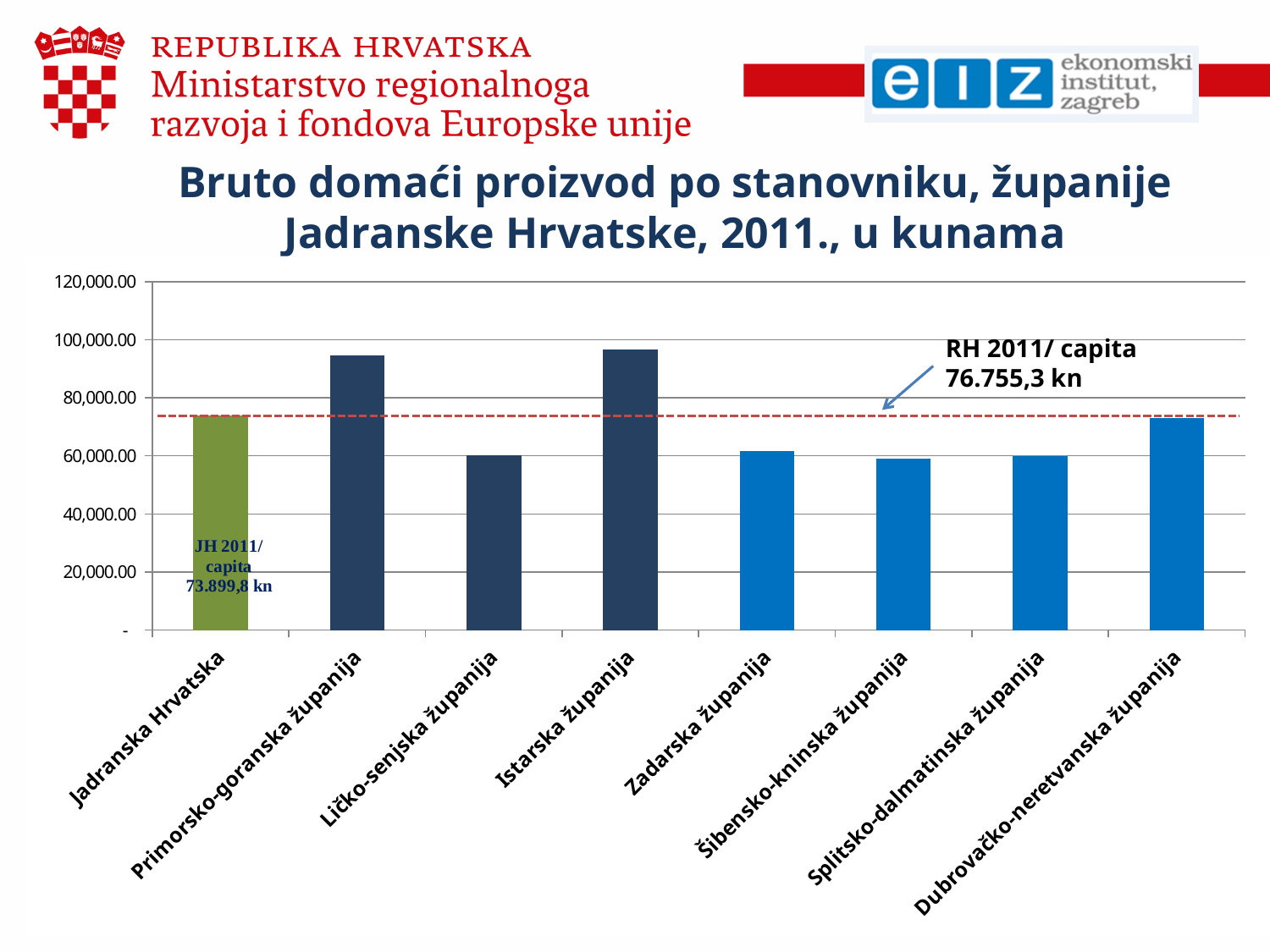
How many bars (categories) are plotted on the chart? 8 What value is given for RH 2011 per capita (the dashed line)? 76.755,3 kn What colour is the bar for Jadranska Hrvatska? green Which is larger, the value for Primorsko-goranska županija or Šibensko-kninska županija? Primorsko-goranska županija Is the value for Primorsko-goranska županija greater or less than 80,000.00? greater What is the GDP per capita value labelled for Jadranska Hrvatska? 73.899,8 kn Which is larger, the value for Istarska županija or Zadarska županija? Istarska županija Is the value for Dubrovačko-neretvanska županija greater or less than 80,000.00? less What kind of chart is shown on the slide? bar chart Is the value for Ličko-senjska županija greater or less than 80,000.00? less How much higher is the RH 2011 per capita value than the Jadranska Hrvatska value? 2.855,5 kn Which county has the highest GDP per capita on the chart? Istarska županija